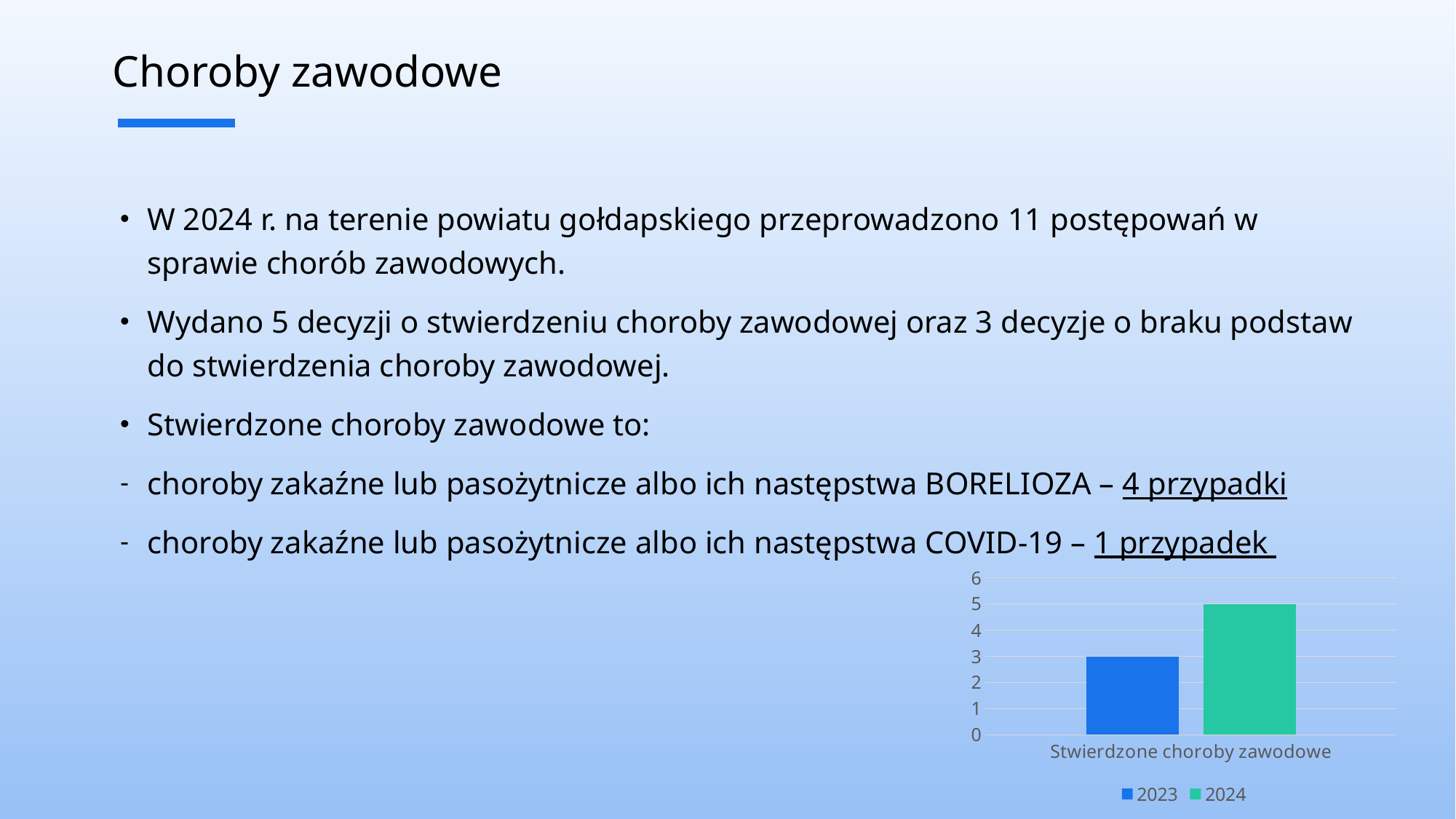
Which series has the lowest value in the chart? 2023 What is the value for 2023 in the chart? 3 Which series has the higher value in the chart, 2023 or 2024? 2024 Which series does the chart legend list? 2023 and 2024 How many series does the chart legend list? 2 What is the value for 2024 in the chart? 5 What is the category label on the x axis of the chart? Stwierdzone choroby zawodowe Is the value for 2023 greater or less than 4? less Is the value for 2024 greater or less than 4? greater What is the difference between the 2024 and 2023 values in the chart? 2 How many categories are shown on the x axis of the chart? 1 What kind of chart is shown on the slide? bar chart